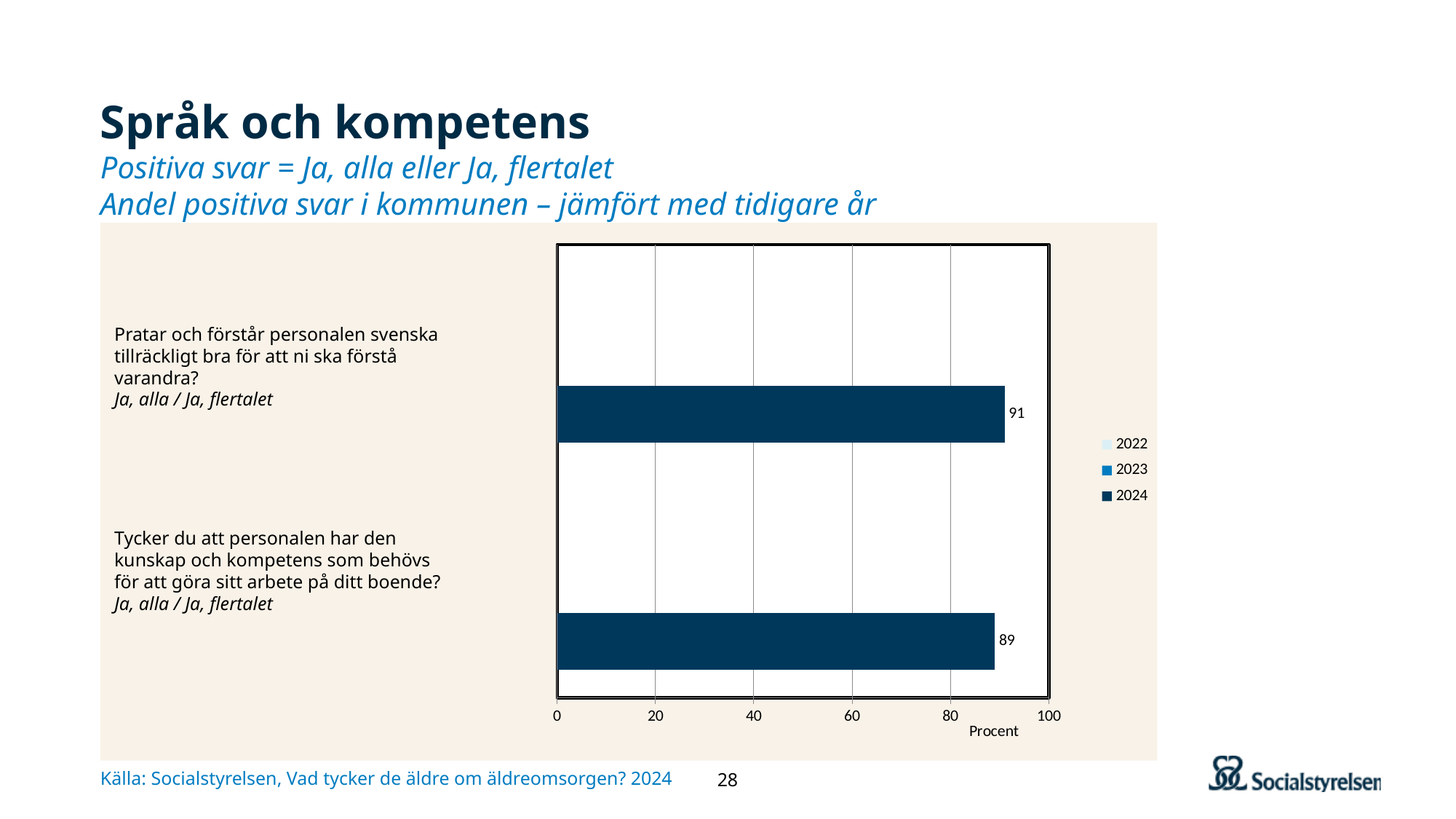
What is the 2024 value for "Pratar och förstår personalen svenska tillräckligt bra för att ni ska förstå varandra?" 91 Which question has the lower 2024 value? Tycker du att personalen har den kunskap och kompetens som behövs för att göra sitt arbete på ditt boende? How many questions (categories) are shown in the chart? 2 Which question has the higher 2024 value? Pratar och förstår personalen svenska tillräckligt bra för att ni ska förstå varandra? What is the label of the horizontal axis? Procent Which years are listed in the legend? 2022, 2023, 2024 Is the 2024 value for the question about staff speaking Swedish greater or less than 80? greater Is the 2024 value for the question about staff knowledge and competence greater or less than 100? less What is the 2024 value for "Tycker du att personalen har den kunskap och kompetens som behövs för att göra sitt arbete på ditt boende?" 89 What is the difference between the two 2024 values shown in the chart? 2 What kind of chart is shown on the slide? Bar chart How many series does the legend list? 3